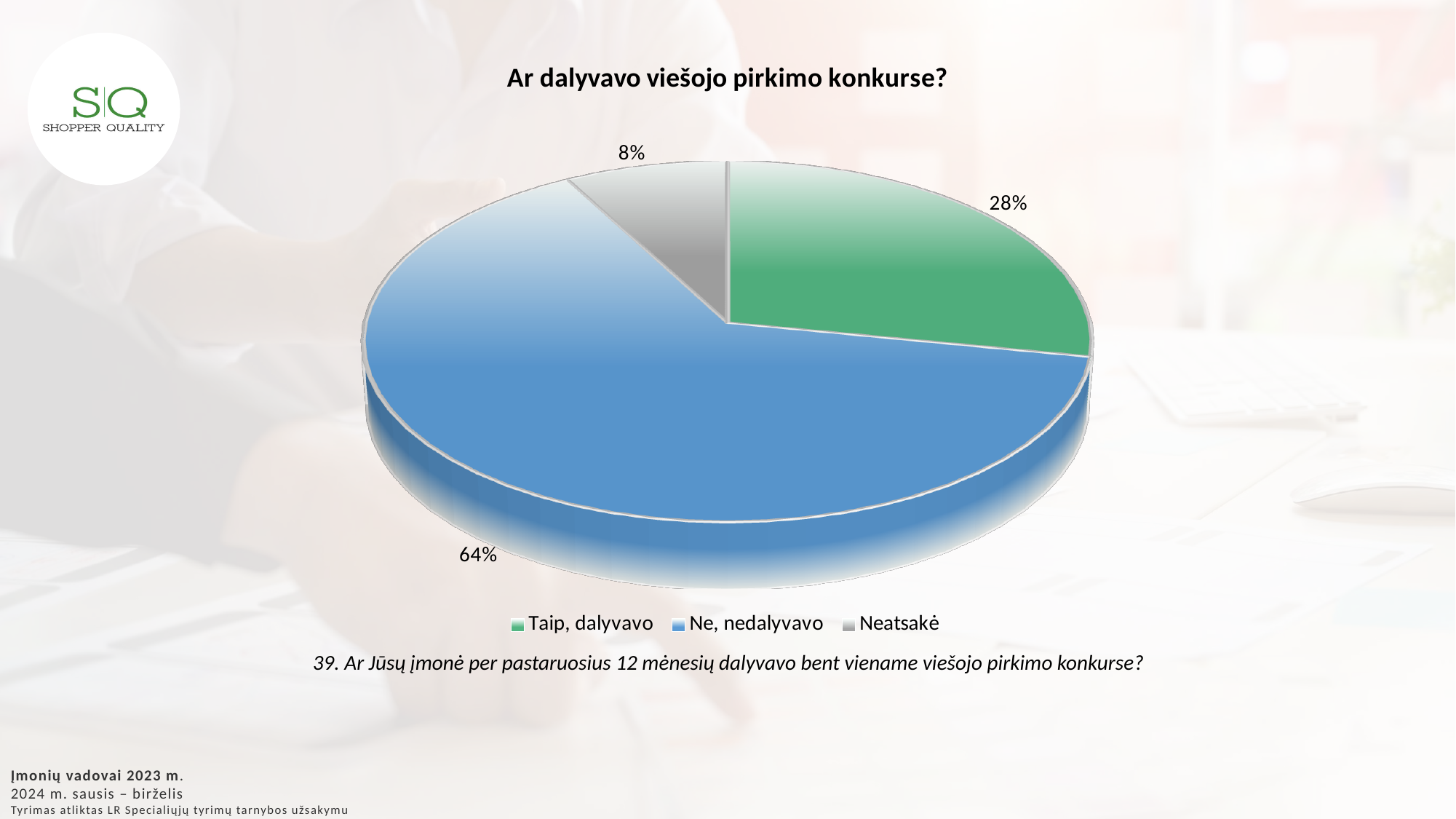
What is the title of the chart? Ar dalyvavo viešojo pirkimo konkurse? What percentage of respondents answered "Ne, nedalyvavo"? 64% How many categories does the pie chart show? 3 Which is larger: the share for "Taip, dalyvavo" or the share for "Neatsakė"? Taip, dalyvavo What is the difference in percentage points between "Ne, nedalyvavo" and "Taip, dalyvavo"? 36 Which category has the largest share of the pie? Ne, nedalyvavo What is the combined share of "Taip, dalyvavo" and "Neatsakė"? 36% Which colour represents "Ne, nedalyvavo" in the chart? Blue Which category has the smallest share of the pie? Neatsakė What kind of chart is shown on the slide? Pie chart What percentage of respondents answered "Taip, dalyvavo"? 28% What percentage of respondents answered "Neatsakė"? 8%